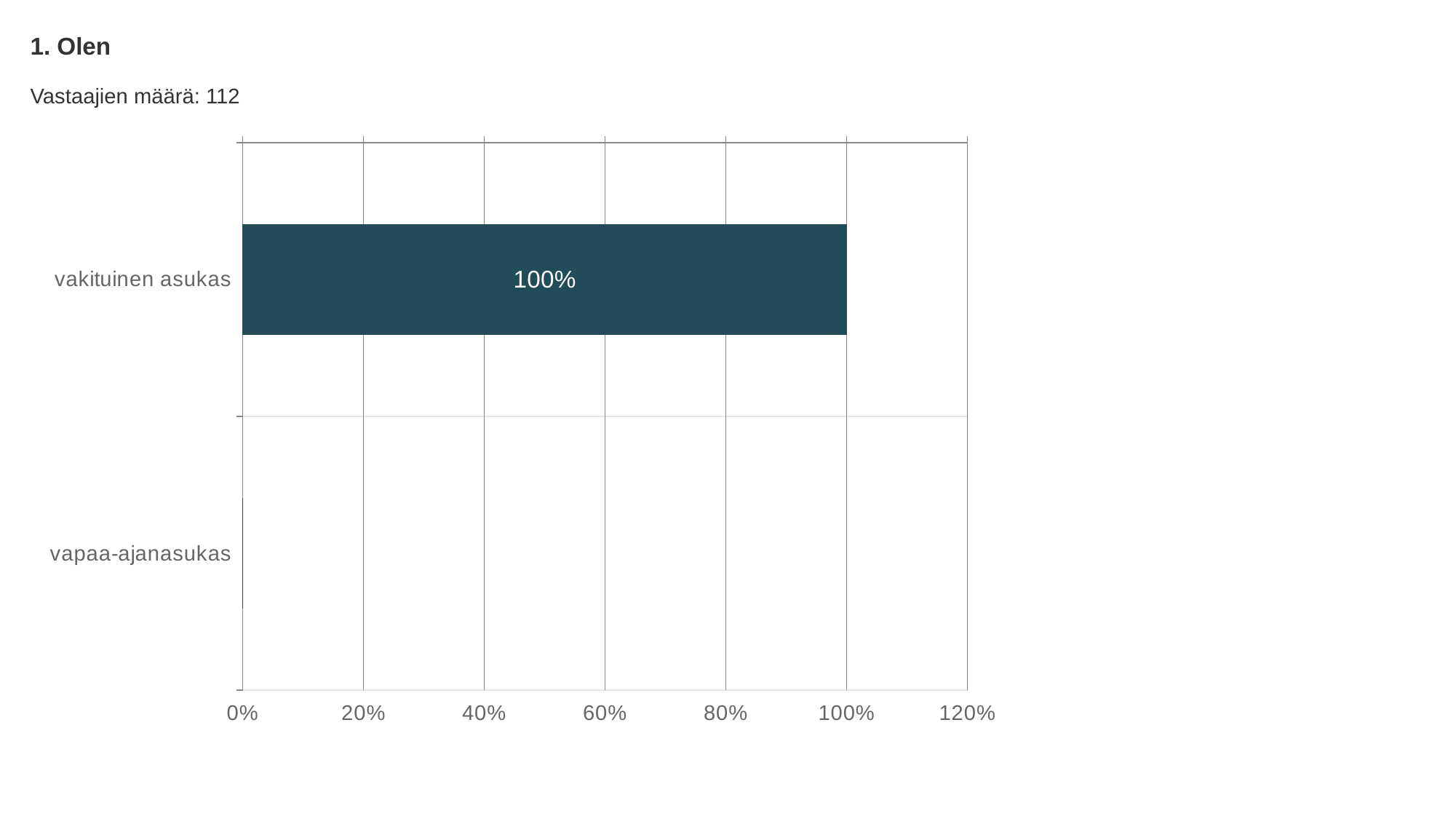
How many categories are shown on the chart? 2 Which is larger, the value for vakituinen asukas or the value for vapaa-ajanasukas? vakituinen asukas Which category has the lowest value? vapaa-ajanasukas What kind of chart is shown on the slide? bar chart What is the highest value shown on the x axis? 120% Is the value for vakituinen asukas greater or less than 80%? greater How many respondents (Vastaajien määrä) are reported on the slide? 112 Is the value for vapaa-ajanasukas greater or less than 20%? less What is the value for vakituinen asukas? 100% Which category has the highest value? vakituinen asukas What is the title of the chart? 1. Olen